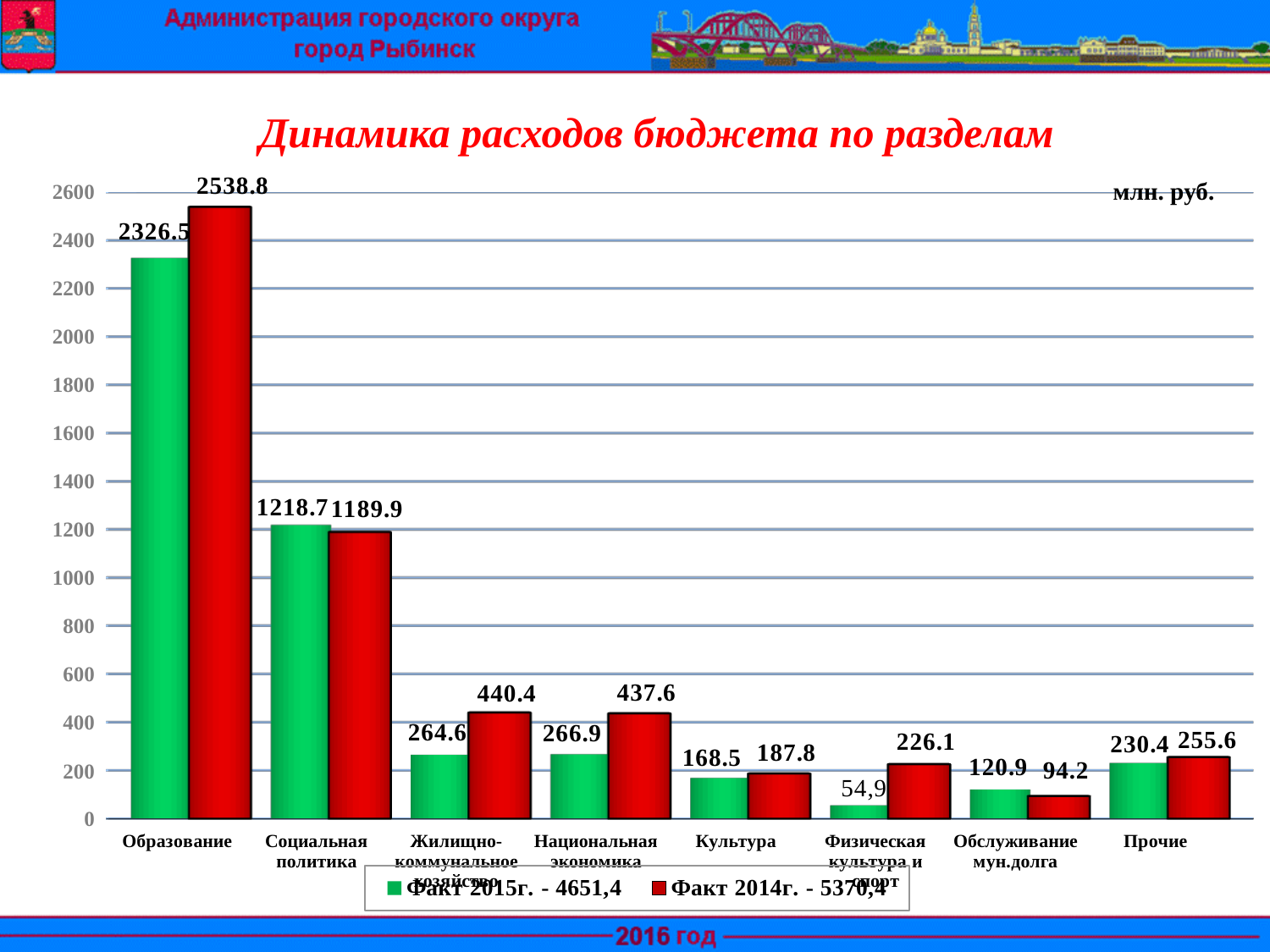
What is the value for Образование in the Факт 2014г. series? 2538.8 What is the value for Обслуживание мун.долга in the Факт 2014г. series? 94.2 How many series does the legend list? 2 What kind of chart is shown on the slide? Bar chart Which category has the highest value in the Факт 2014г. series? Образование What unit is indicated in the top right corner of the chart? млн. руб. How many categories are shown on the x axis? 8 What is the value for Физическая культура и спорт in the Факт 2015г. series? 54,9 Which is larger for Социальная политика: the Факт 2015г. value or the Факт 2014г. value? Факт 2015г. What is the value for Образование in the Факт 2015г. series? 2326.5 What is the difference between the Факт 2014г. and Факт 2015г. values for Жилищно-коммунальное хозяйство? 175.8 Which category has the lowest value in the Факт 2015г. series? Физическая культура и спорт